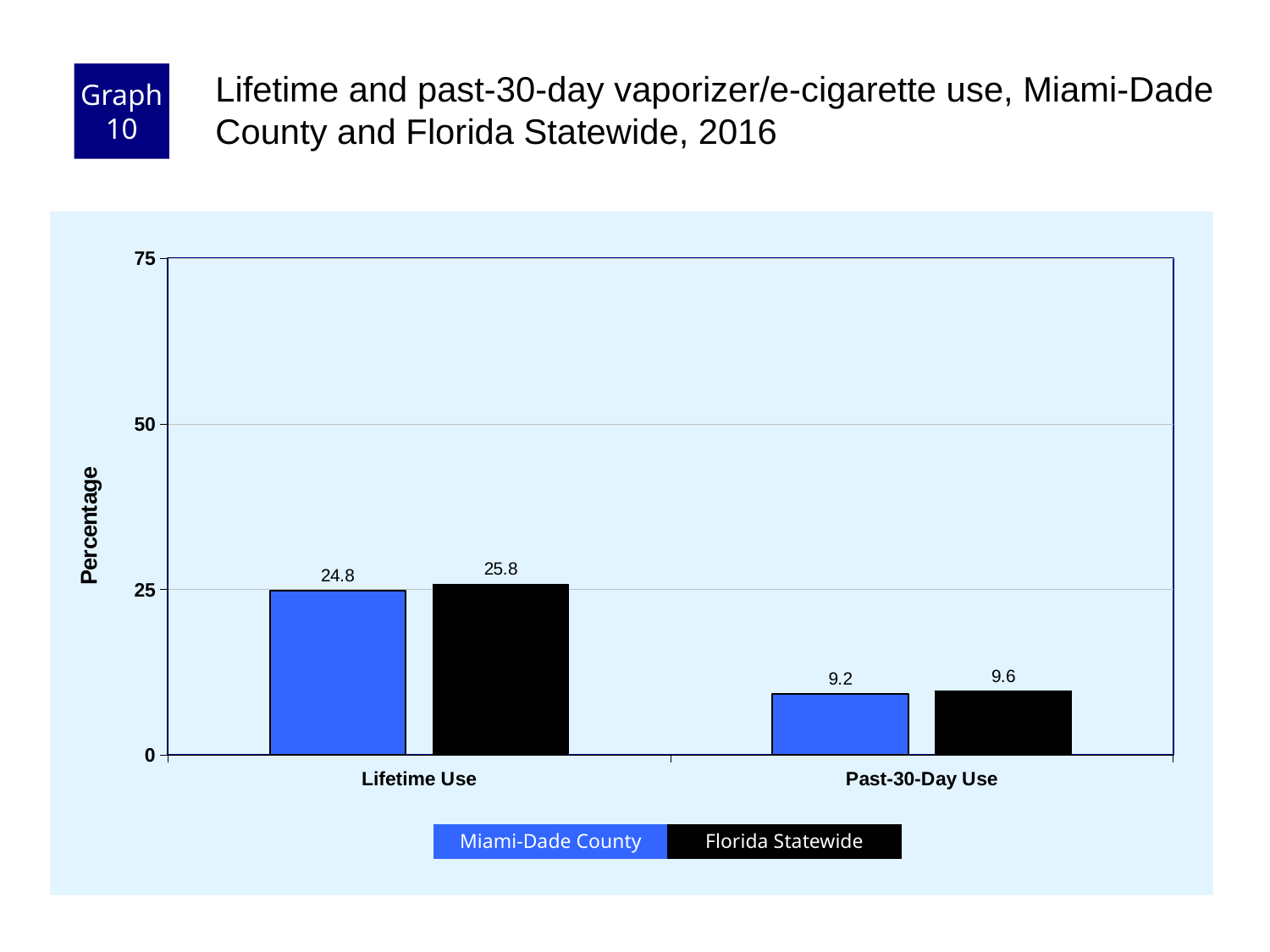
How many categories are shown on the x axis? 2 What is the Miami-Dade County value for Past-30-Day Use? 9.2 What is the difference between the Florida Statewide and Miami-Dade County values for Lifetime Use? 1.0 Which category has the highest Florida Statewide value? Lifetime Use What is the Florida Statewide value for Past-30-Day Use? 9.6 What is the difference between the Florida Statewide and Miami-Dade County values for Past-30-Day Use? 0.4 Which category has the lowest Miami-Dade County value? Past-30-Day Use What is the Florida Statewide value for Lifetime Use? 25.8 What kind of chart is shown on the slide? bar chart How many series does the legend list? 2 What is the Miami-Dade County value for Lifetime Use? 24.8 Is the Miami-Dade County value for Lifetime Use greater or less than 50? less